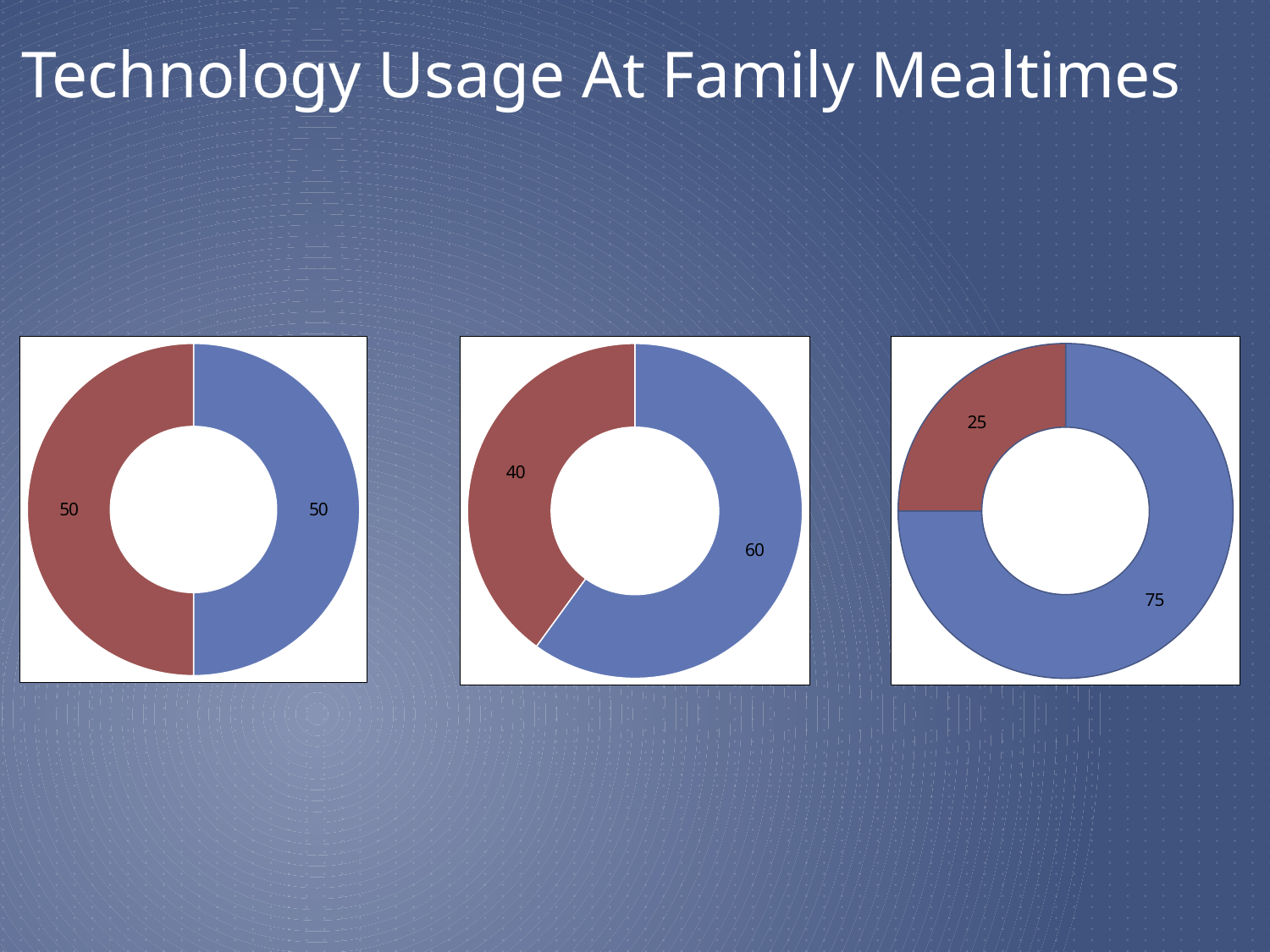
In the middle chart, what is the difference between the blue slice and the red slice? 20 In the right chart, what value is shown for the blue slice? 75 How many charts are shown on the slide? 3 How many slices does the right chart have? 2 In the left chart, what value is shown for the red slice? 50 In the right chart, what value is shown for the red slice? 25 In the middle chart, what value is shown for the red slice? 40 In the left chart, what value is shown for the blue slice? 50 In the middle chart, what value is shown for the blue slice? 60 What type of chart is shown on the left of the slide? doughnut chart In the right chart, what is the difference between the blue slice and the red slice? 50 In the middle chart, which slice is larger, the blue one or the red one? blue